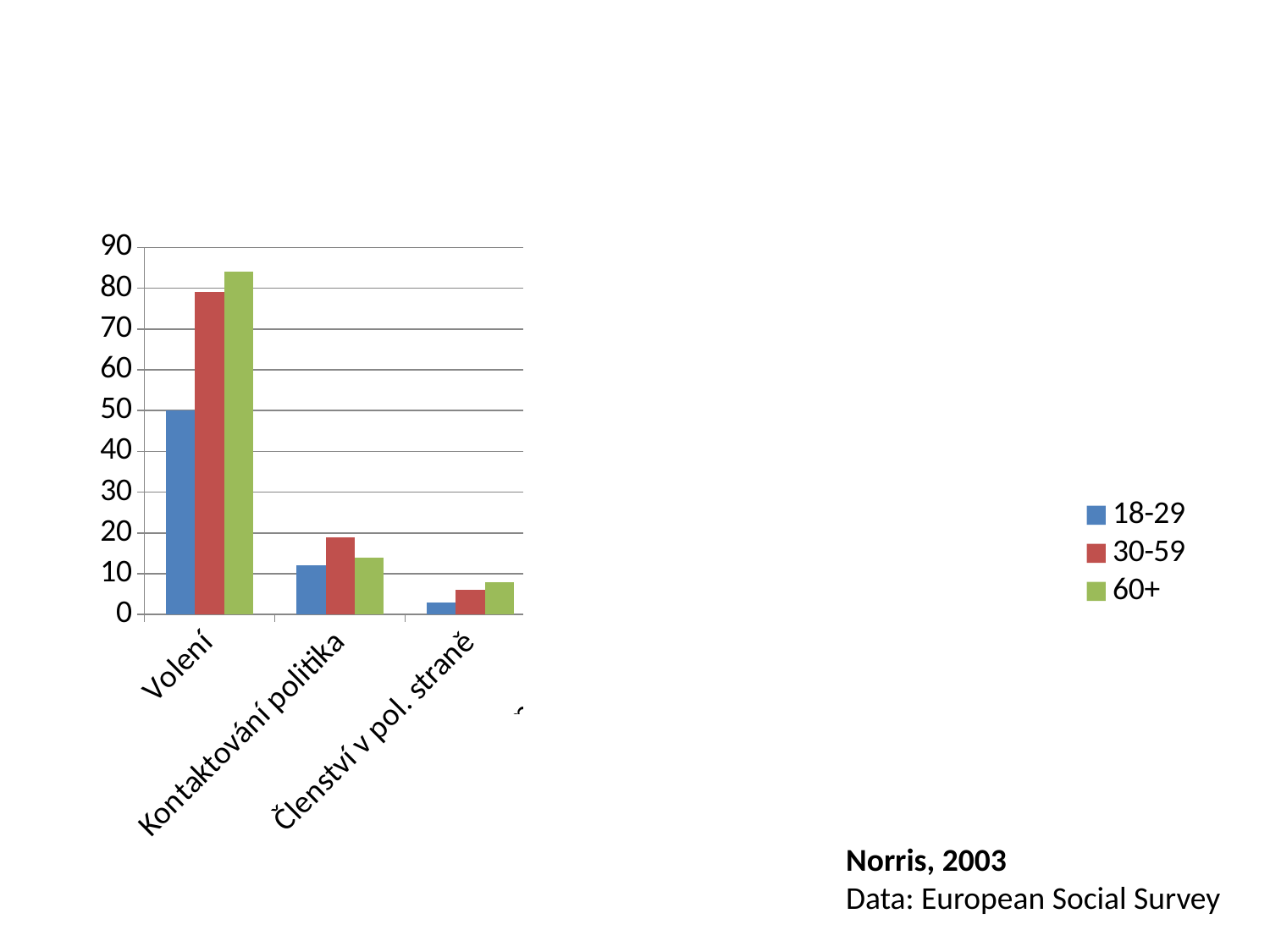
Which age group has the highest value for Kontaktování politika? 30-59 Is the value for the 60+ group for Členství v pol. straně greater or less than 10? less What are the three entries listed in the legend? 18-29, 30-59, 60+ How many series does the legend list? 3 For the 60+ group, which category has the larger value: Volení or Kontaktování politika? Volení Which age group has the highest value for Volení? 60+ Which age group has the lowest value for Členství v pol. straně? 18-29 Which age group has the lowest value for Volení? 18-29 Is the value for the 30-59 group for Volení greater or less than 70? greater For Kontaktování politika, which is larger: the value for 30-59 or the value for 60+? 30-59 Is the value for the 18-29 group for Kontaktování politika greater or less than 20? less What kind of chart is shown on the slide? bar chart